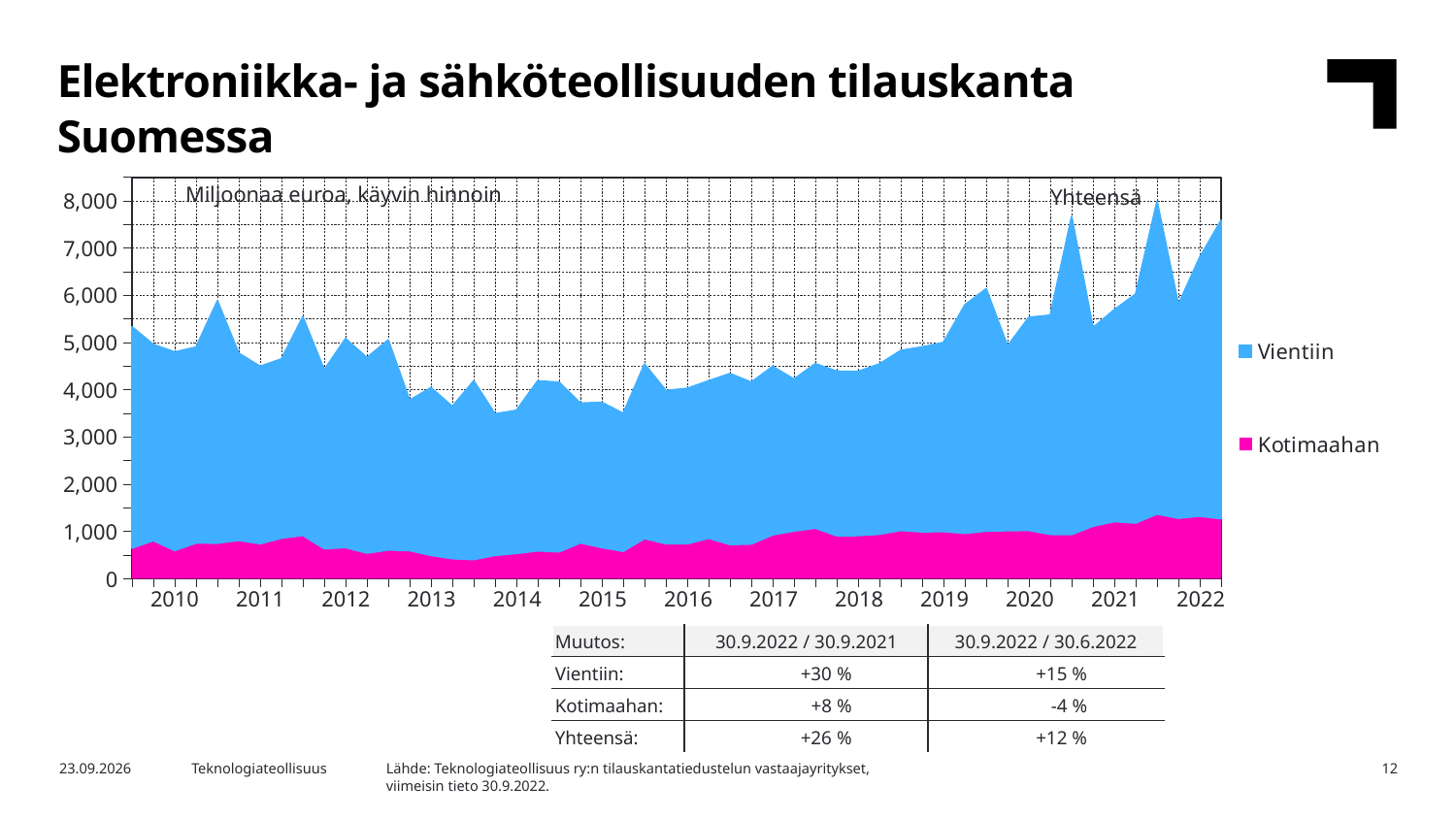
Does the total order book generally rise or fall from 2019 to 2022? rise What are the two series named in the chart legend? Vientiin and Kotimaahan How many years are labelled on the x axis of the chart? 13 Is the Kotimaahan value in 2014 greater or less than 1,000? less What kind of chart is shown on the slide? area chart Does the total order book generally rise or fall from 2010 to 2015? fall What unit label is shown at the top of the chart? Miljoonaa euroa, käyvin hinnoin Is the total (Yhteensä) value at the end of 2022 greater or less than 7,000? greater Is the Kotimaahan value at the end of 2022 greater or less than 1,000? greater Which series is larger throughout the chart, Vientiin or Kotimaahan? Vientiin How many series does the chart legend list? 2